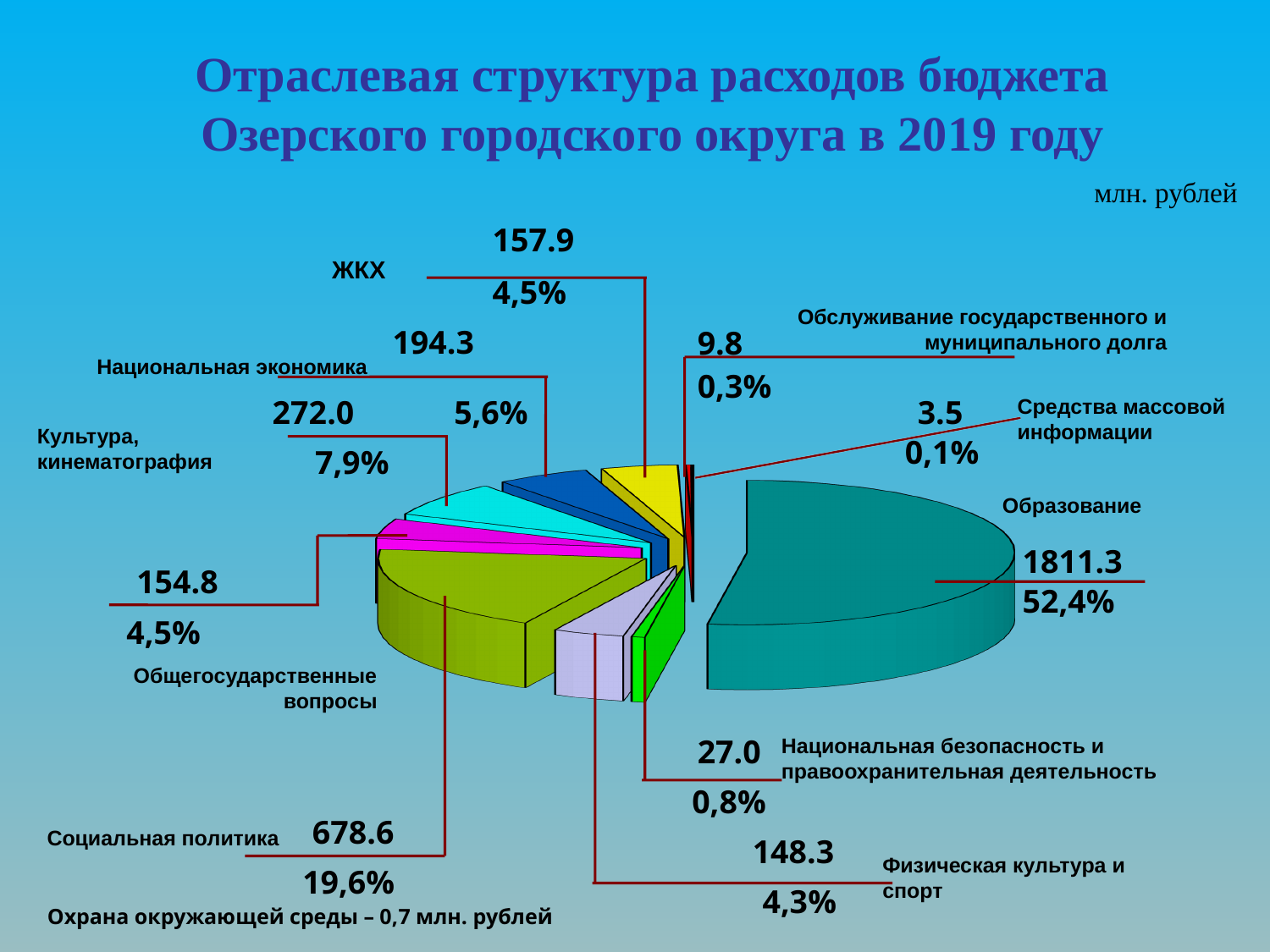
Which is larger: ЖКХ or Физическая культура и спорт? ЖКХ Which category has the largest share of expenditure? Образование In what units are the chart values given? млн. рублей What percentage share is shown for Культура, кинематография? 7,9% What type of chart is shown on the slide? pie chart What is the value for Образование in million rubles? 1811.3 What share of the budget expenditure does Образование account for? 52,4% What is the value for Социальная политика? 678.6 What is the value for Национальная экономика? 194.3 Which category has the smallest value in the pie chart? Средства массовой информации What is the value for Национальная безопасность и правоохранительная деятельность? 27.0 What is the difference between Социальная политика and Культура, кинематография in million rubles? 406.6